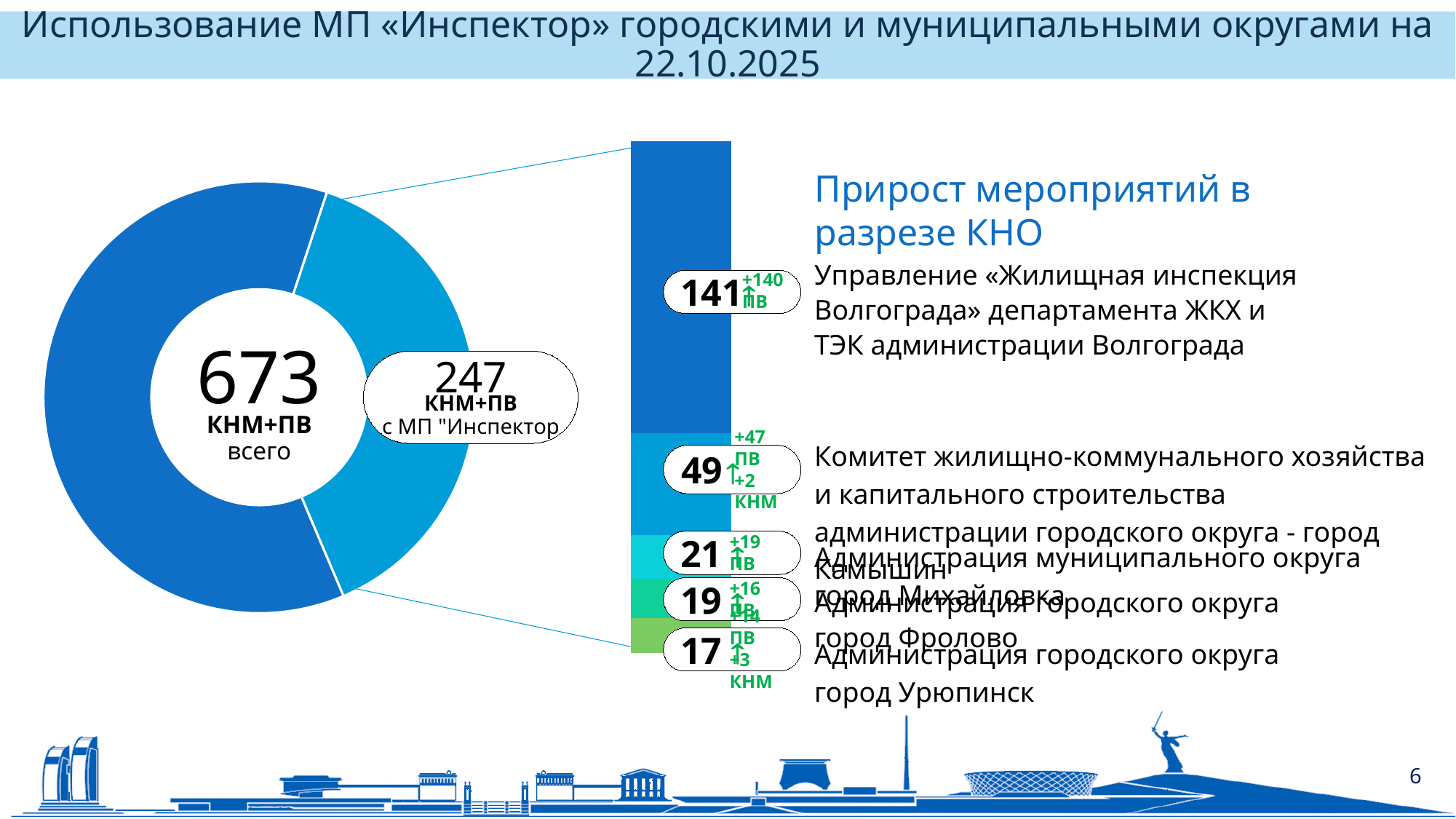
In the donut chart on the left, how many КНМ+ПВ were carried out with МП "Инспектор"? 247 In the stacked bar chart, what is the value for Администрация городского округа город Урюпинск? 17 In the stacked bar chart, which is larger: the value for город Михайловка or for город Фролово? город Михайловка How many segments (organisations) does the stacked bar chart contain? 5 In the stacked bar chart, what is the difference between the values for Волгоград's Жилищная инспекция (141) and Камышин (49)? 92 In the stacked bar chart, which organisation has the largest segment? Управление «Жилищная инспекция Волгограда» What is the total of all segments in the stacked bar chart? 247 In the donut chart on the left, what is the total number of КНМ+ПВ (всего)? 673 In the stacked bar chart, which organisation has the smallest segment? Администрация городского округа город Урюпинск What type of chart is shown on the left side of the slide? Donut (pie) chart In the stacked bar chart, what is the value for the Комитет жилищно-коммунального хозяйства и капитального строительства of Камышин? 49 In the stacked bar chart, what is the value for Управление «Жилищная инспекция Волгограда»? 141